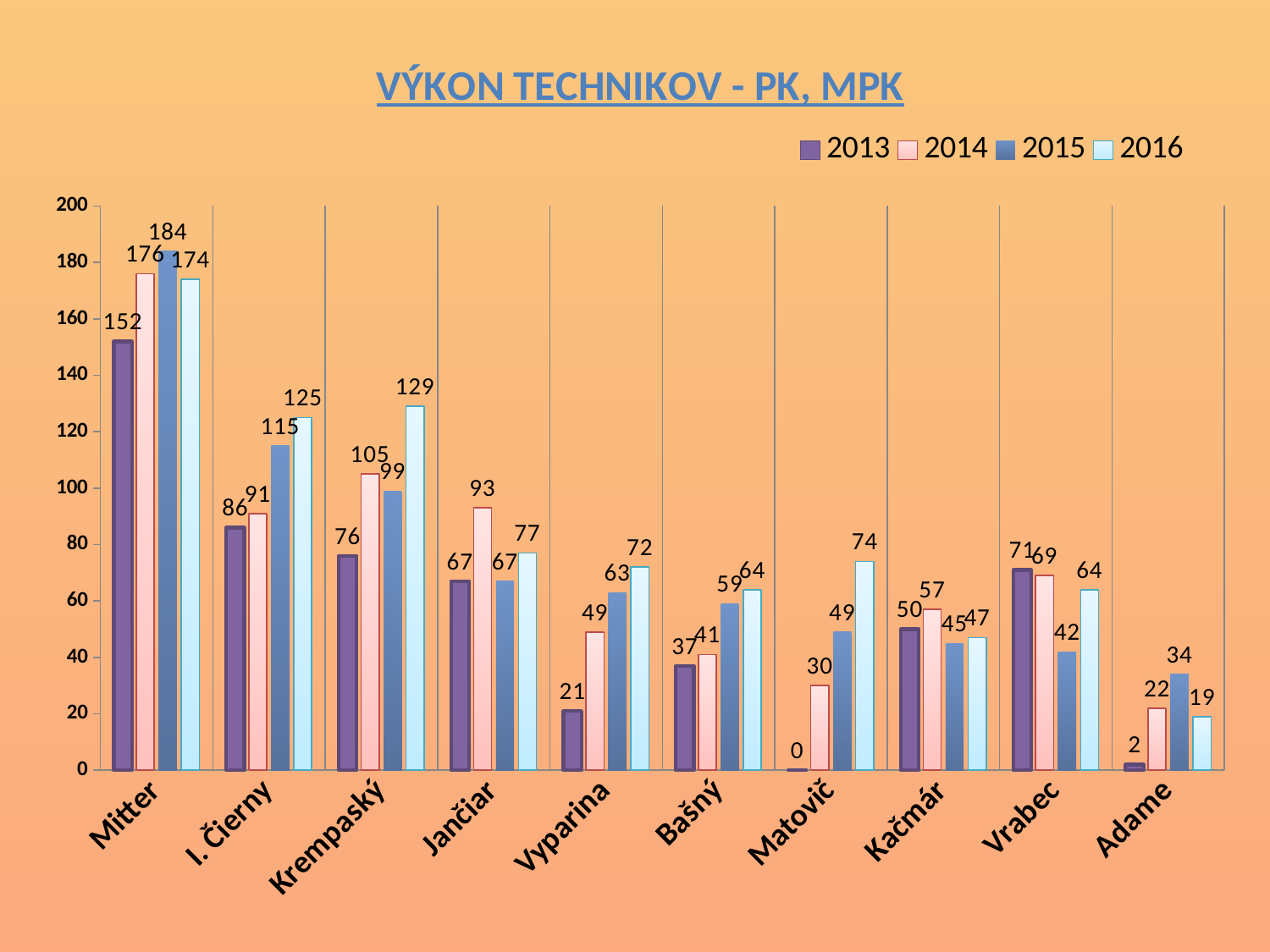
What is the value for Mitter in 2015? 184 Which technician has the lowest value in 2016? Adame What is the value for Krempaský in 2016? 129 What is the value for Matovič in 2013? 0 What is the difference between the 2016 and 2013 values for Vyparina? 51 How many technicians are shown on the x axis? 10 Which technician has the highest value in 2014? Mitter How many series does the legend list? 4 Is the value for I. Čierny in 2015 greater or less than 100? greater What kind of chart is shown on the slide? bar chart Which is larger for Jančiar: the 2014 value or the 2016 value? 2014 What is the title of the chart? VÝKON TECHNIKOV - PK, MPK